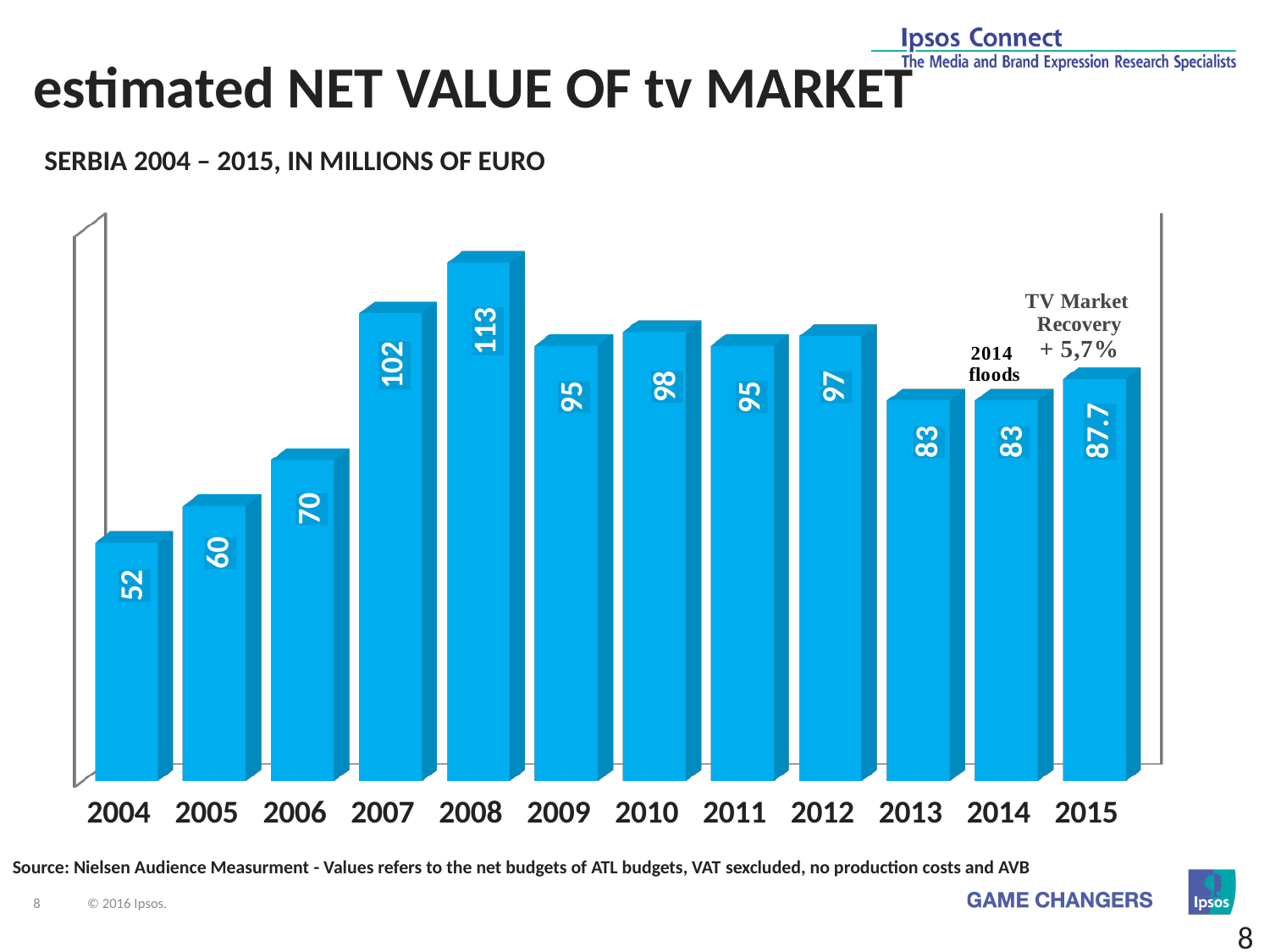
What is the estimated net value of the TV market in 2008? 113 How many years are shown on the x axis? 12 What is the value shown for 2015? 87.7 Which year has the lowest value? 2004 What annotation is placed above the 2014 bar? 2014 floods What kind of chart is shown on the slide? bar chart Do the values rise or fall from 2004 to 2008? rise Which is larger, the value for 2010 or the value for 2012? 2010 What is the value shown for 2004? 52 What is the difference between the values for 2015 and 2014? 4.7 Which year has the highest value? 2008 What is the difference between the values for 2008 and 2007? 11